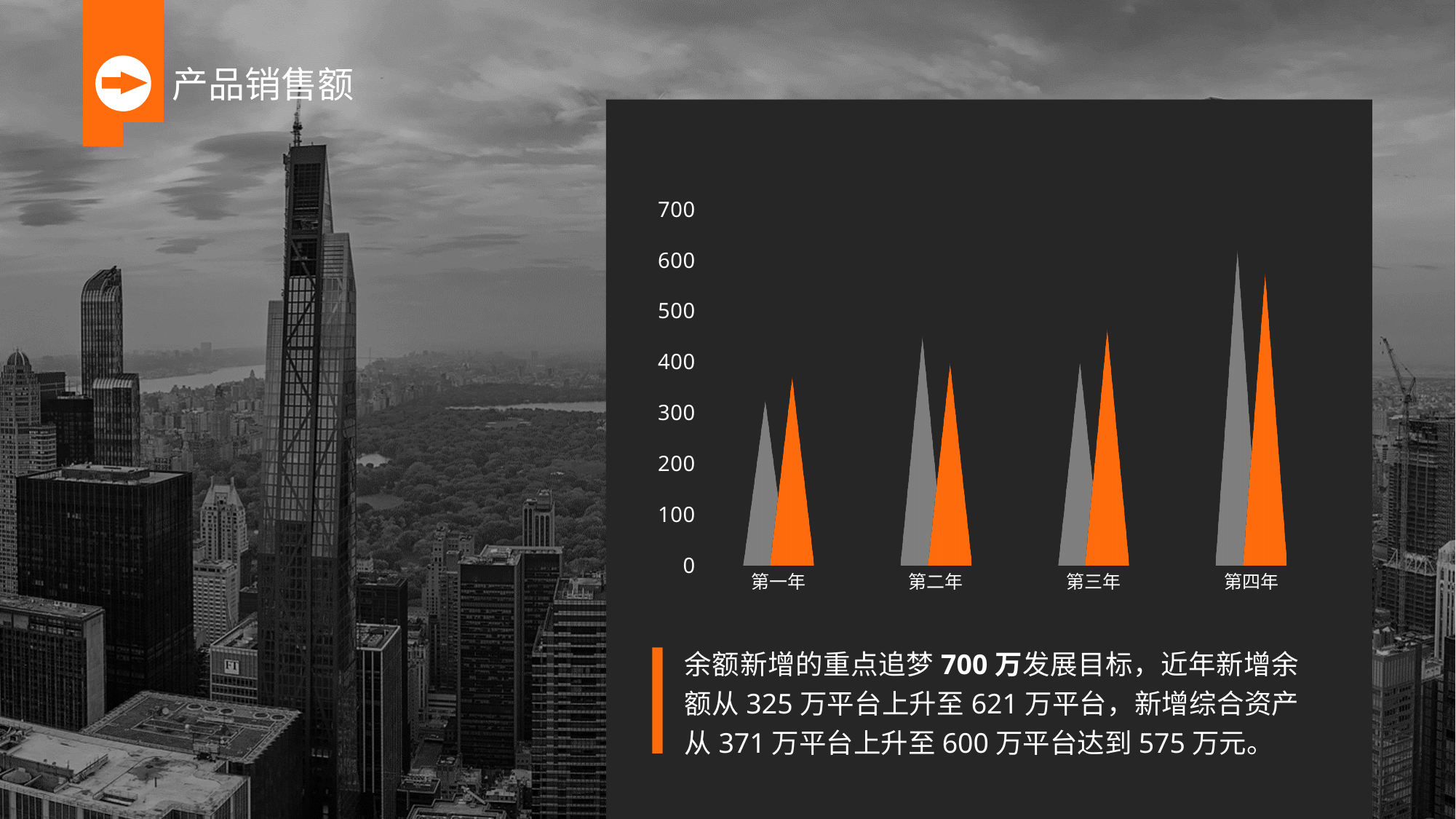
What kind of chart is shown on the slide? bar chart What is the title of the slide containing the chart? 产品销售额 Which category has the highest orange bar? 第四年 What two colours are used for the bars in the chart? grey and orange Is the grey bar for 第一年 greater or less than 400? less For 第一年, which bar is taller, the grey one or the orange one? orange Which category has the lowest grey bar? 第一年 How many categories are shown on the x axis of the chart? 4 Do the orange bars rise or fall from 第一年 to 第四年? rise Is the grey bar for 第四年 greater or less than 500? greater Which category has the highest grey bar? 第四年 Is the orange bar for 第三年 greater or less than 400? greater